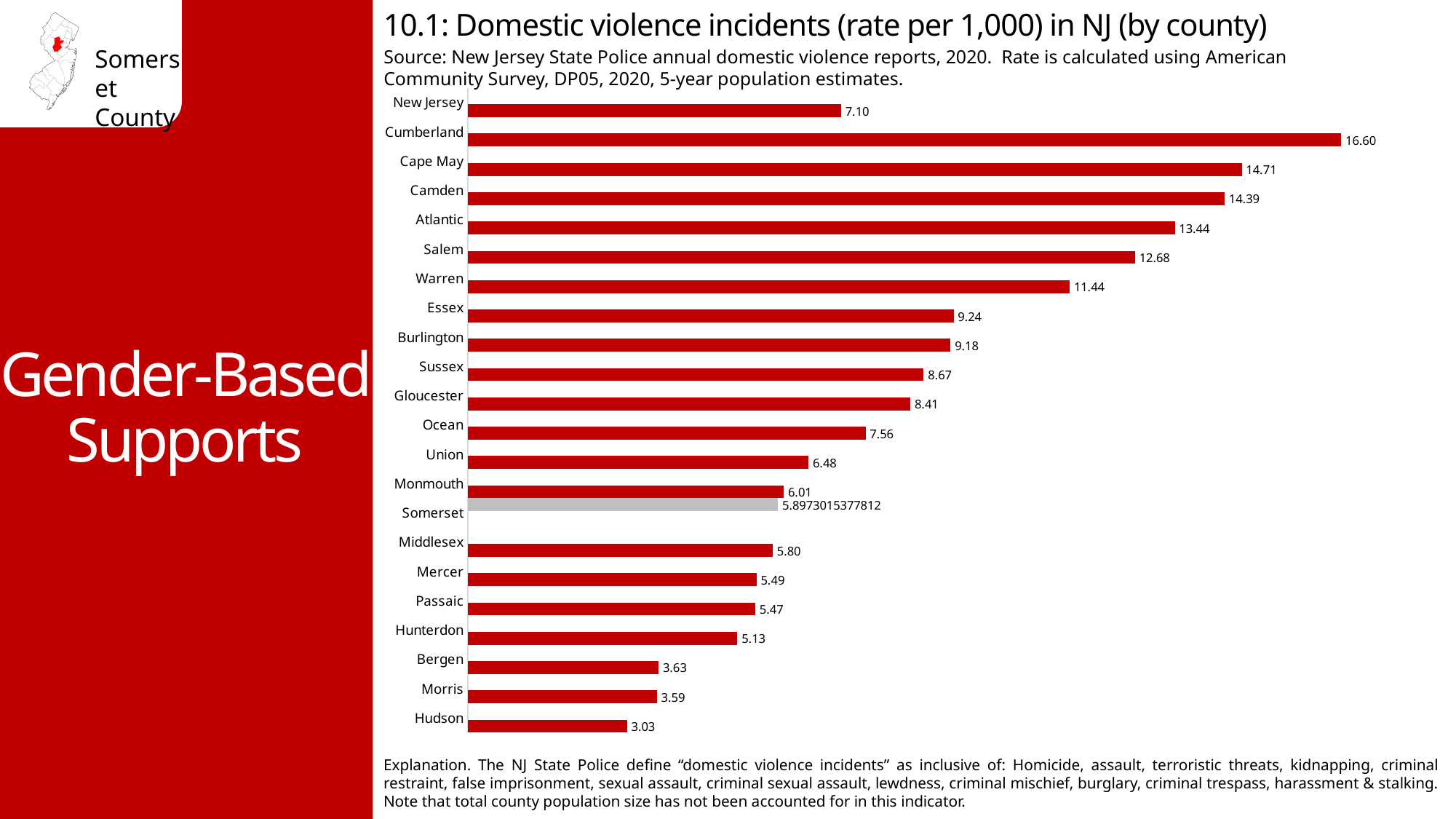
What value is labelled on the Somerset bar? 5.8973015377812 What is the domestic violence incident rate per 1,000 for Cumberland county? 16.60 Which bar is coloured grey instead of red? Somerset What is the rate per 1,000 for Hudson county? 3.03 Which county has the lowest domestic violence incident rate? Hudson Which has a higher rate, Cape May or Camden? Cape May How many bars (categories) are shown in the chart? 22 What type of chart is used on this slide? Bar chart Which has a higher rate, Monmouth or Middlesex? Monmouth What is the difference between the rates for Cumberland and Hudson? 13.57 Which county has the highest domestic violence incident rate? Cumberland What is the rate per 1,000 shown for New Jersey overall? 7.10